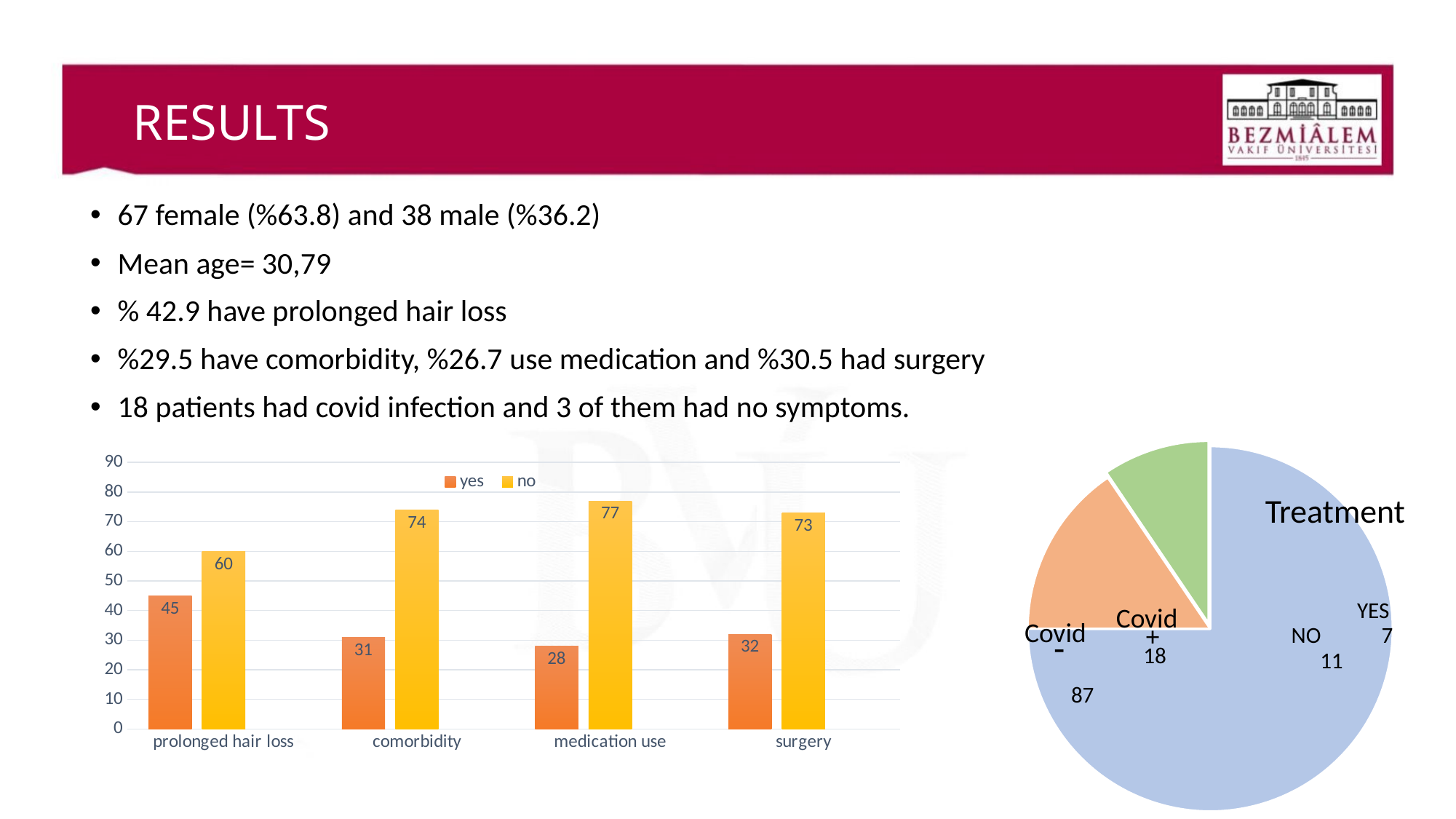
In the pie chart on the right, what value is shown for 'Covid -'? 87 In the bar chart on the left, what is the 'yes' value for prolonged hair loss? 45 In the bar chart on the left, which category has the lowest 'yes' value? medication use In the bar chart on the left, what is the 'yes' value for medication use? 28 In the bar chart on the left, what is the difference between the 'no' and 'yes' values for prolonged hair loss? 15 In the bar chart on the left, which category has the highest 'no' value? medication use In the bar chart on the left, what is the 'no' value for surgery? 73 What kind of chart is the chart on the right of the slide? pie chart In the bar chart on the left, which is larger: the 'no' value for medication use or the 'no' value for surgery? medication use How many series does the legend of the bar chart on the left list? 2 How many categories are shown on the x axis of the bar chart on the left? 4 In the bar chart on the left, what is the 'no' value for comorbidity? 74